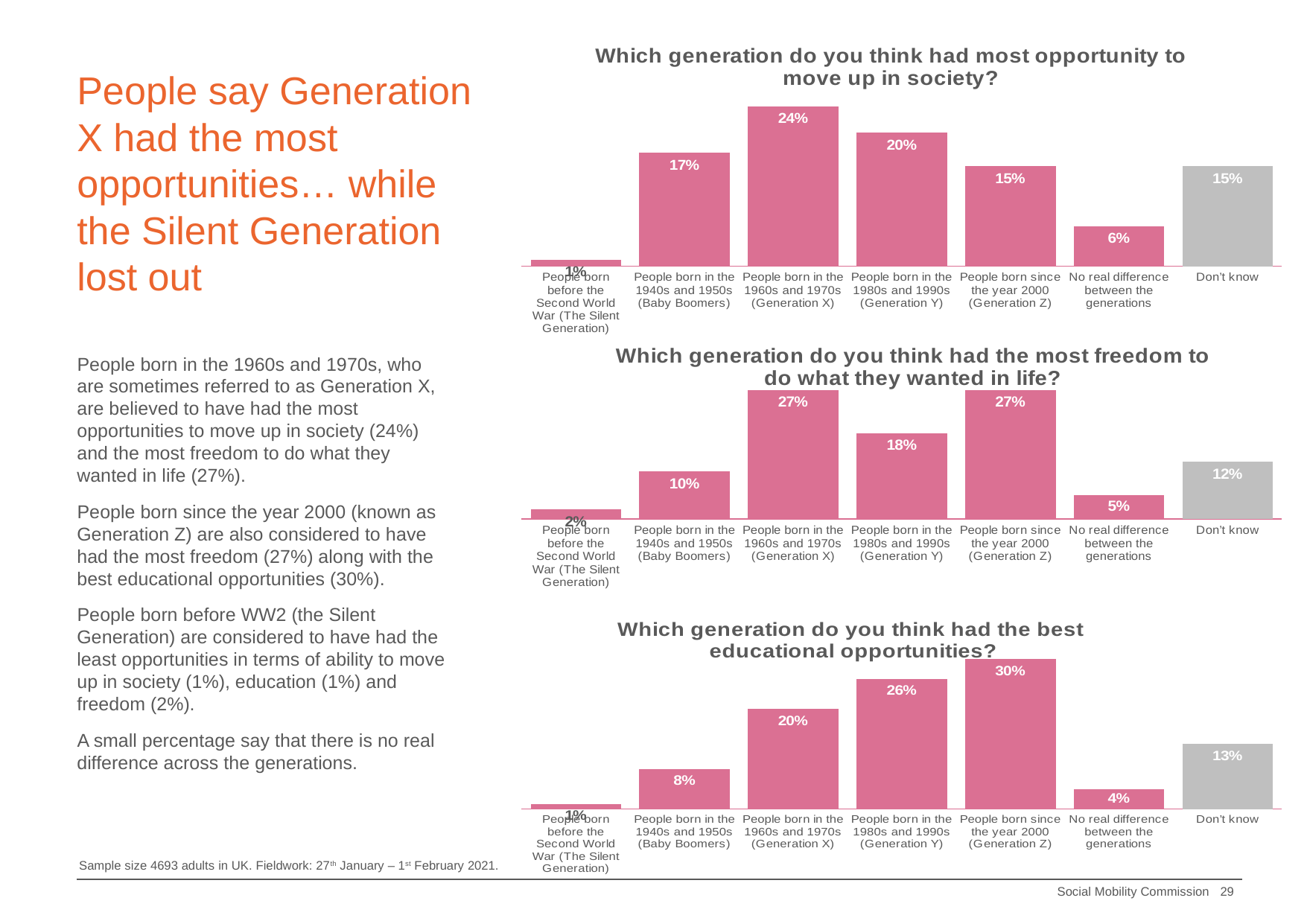
What type of chart is the top chart on the slide? Bar chart In the chart titled "Which generation do you think had the most freedom to do what they wanted in life?", what is the value for People born in the 1980s and 1990s (Generation Y)? 18% How many categories are shown in the chart titled "Which generation do you think had the best educational opportunities?"? 7 In the chart titled "Which generation do you think had most opportunity to move up in society?", what is the value for People born in the 1960s and 1970s (Generation X)? 24% In the chart titled "Which generation do you think had the most freedom to do what they wanted in life?", which is larger: the value for Baby Boomers or the value for Generation Y? Generation Y In the chart titled "Which generation do you think had the best educational opportunities?", which category has the highest value? People born since the year 2000 (Generation Z) In the chart titled "Which generation do you think had the most freedom to do what they wanted in life?", what is the value for Don't know? 12% In the chart titled "Which generation do you think had the best educational opportunities?", what is the value for People born in the 1940s and 1950s (Baby Boomers)? 8% In the chart titled "Which generation do you think had most opportunity to move up in society?", what is the difference between the values for Baby Boomers and Generation Z? 2% In the chart titled "Which generation do you think had most opportunity to move up in society?", what is the value for No real difference between the generations? 6% In the chart titled "Which generation do you think had the best educational opportunities?", what is the difference between the values for Generation Z and Generation X? 10% In the chart titled "Which generation do you think had most opportunity to move up in society?", which category has the lowest value? People born before the Second World War (The Silent Generation)